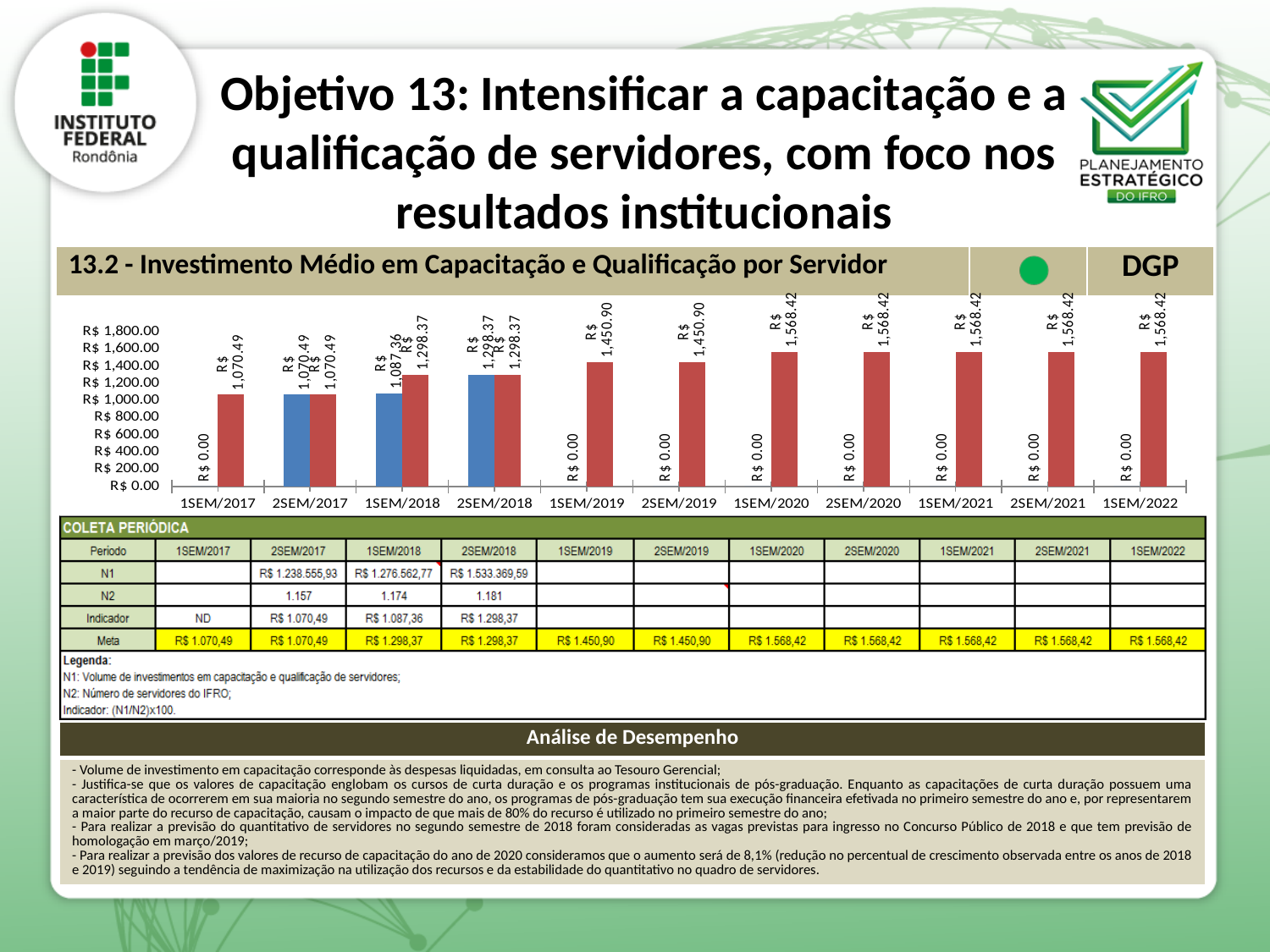
What is the difference between the Meta and Indicador values for 1SEM/2018? R$ 211.01 Which is larger for 1SEM/2018: the Indicador value or the Meta value? Meta What is the title of the indicator shown above the chart? 13.2 - Investimento Médio em Capacitação e Qualificação por Servidor How many periods (categories) are shown on the x axis of the chart? 11 What is the Meta value for 1SEM/2022 in the chart? R$ 1,568.42 What is the Meta (red bar) value for 1SEM/2017 in the chart? R$ 1,070.49 What is the Indicador (blue bar) value for 1SEM/2018 in the chart? R$ 1,087.36 Do the Meta (red bar) values rise or fall from 1SEM/2017 to 1SEM/2022? rise What is the Meta value for 1SEM/2019 in the chart? R$ 1,450.90 Is the Meta value for 2SEM/2020 greater or less than R$ 1,400.00? greater What type of chart is shown on the slide? bar chart What is the Indicador value shown for 2SEM/2018 in the chart? R$ 1,298.37